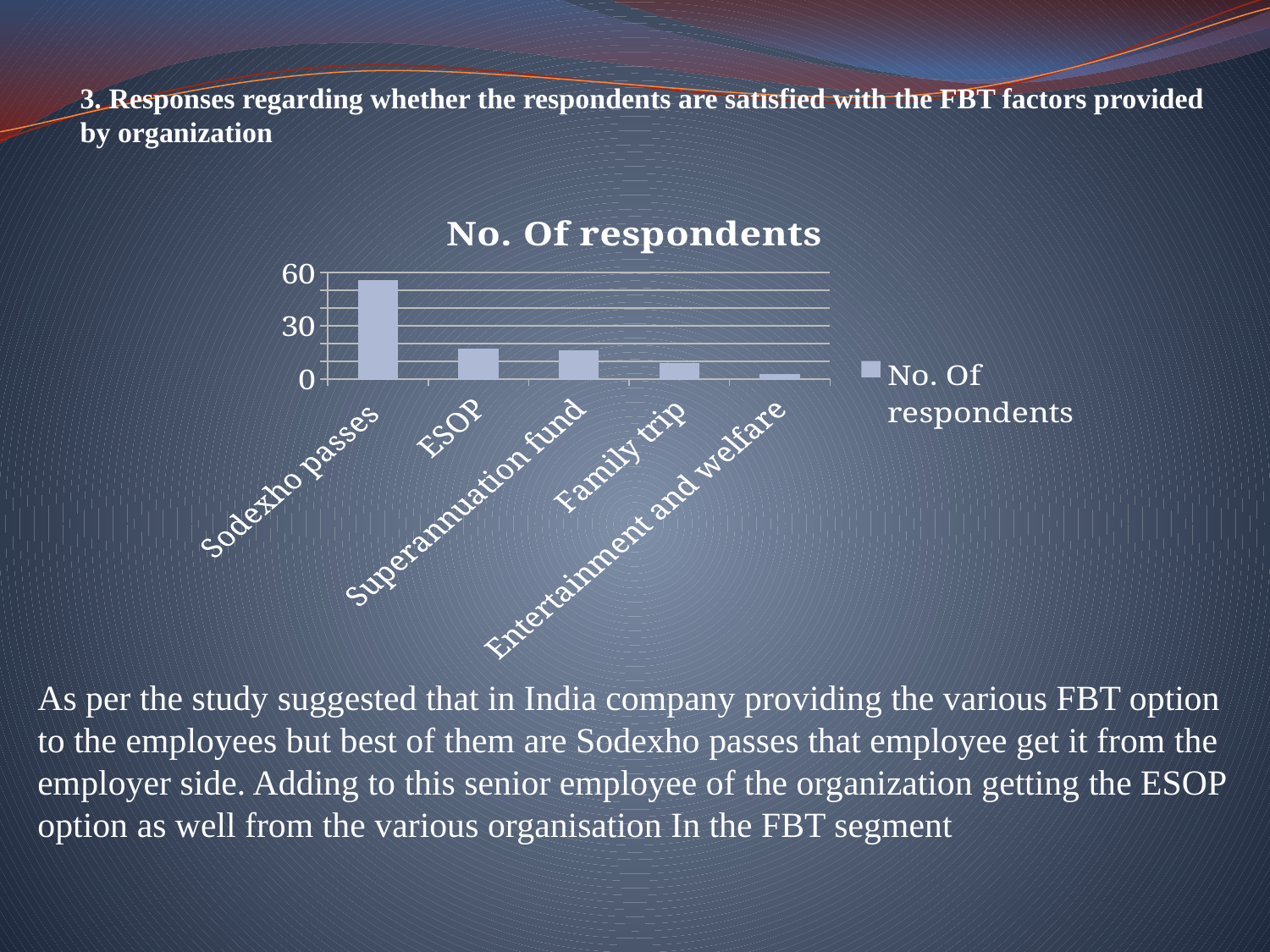
Which has more respondents, Sodexho passes or Family trip? Sodexho passes Which has more respondents, ESOP or Entertainment and welfare? ESOP Is the value for Sodexho passes greater or less than 30? greater Do the values generally rise or fall moving from left to right along the x axis? fall Is the value for Family trip greater or less than 30? less Which category has the lowest number of respondents? Entertainment and welfare What is the title of the chart? No. Of respondents Which category has the highest number of respondents? Sodexho passes What kind of chart is shown on the slide? bar chart How many series does the chart's legend list? 1 Is the value for ESOP greater or less than 30? less How many categories are shown on the x axis of the chart? 5